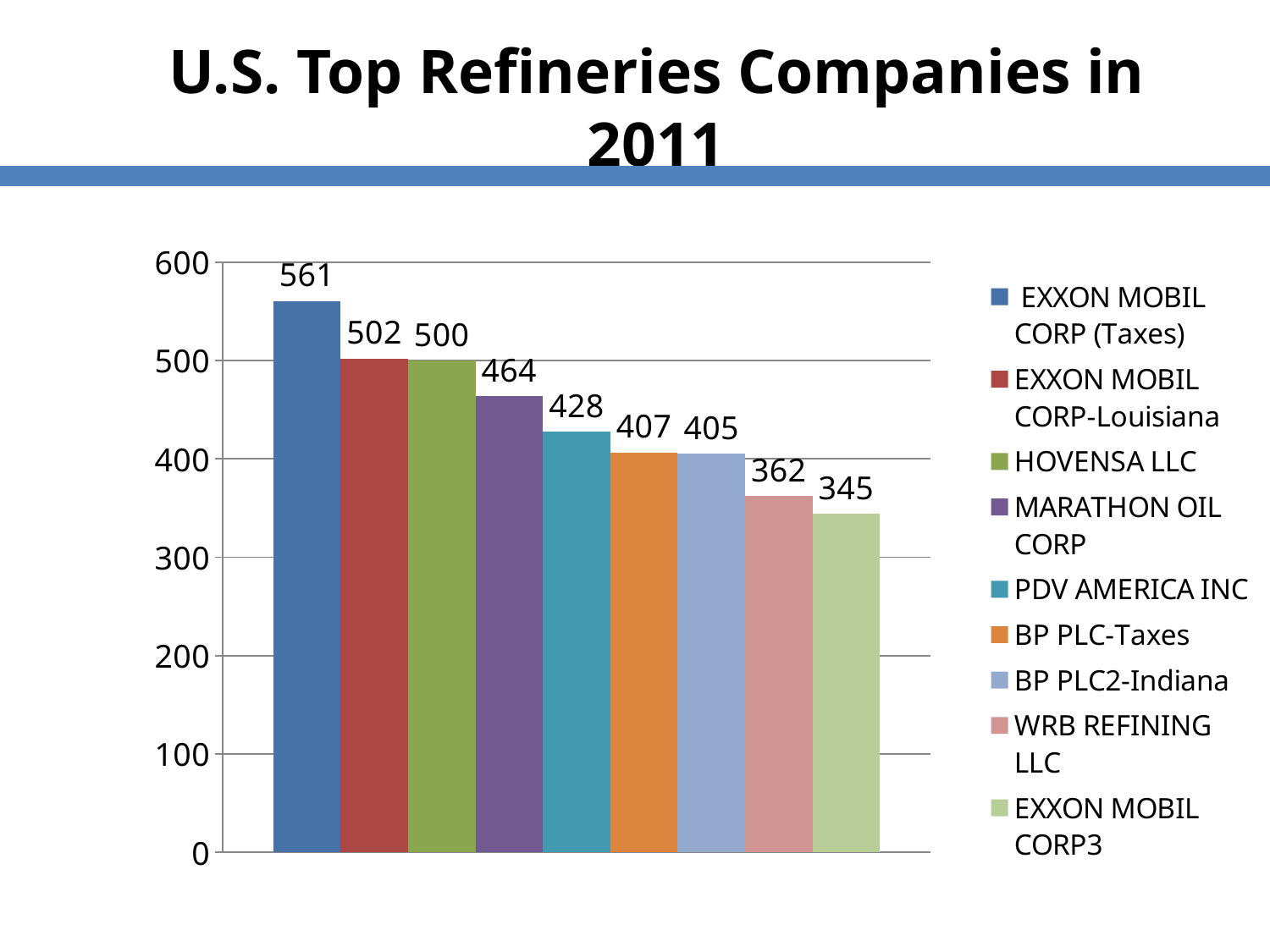
What is the difference between the values for EXXON MOBIL CORP (Taxes) and EXXON MOBIL CORP3? 216 What is the value for WRB REFINING LLC? 362 What is the value for EXXON MOBIL CORP (Taxes)? 561 What is the value for HOVENSA LLC? 500 What is the difference between the values for MARATHON OIL CORP and PDV AMERICA INC? 36 How many companies are shown in the chart? 9 What is the value for PDV AMERICA INC? 428 What kind of chart is shown on the slide? Bar chart Which company has the highest value? EXXON MOBIL CORP (Taxes) Which company has the lowest value? EXXON MOBIL CORP3 Do the values rise or fall from left to right across the bars? Fall Which is larger, the value for EXXON MOBIL CORP-Louisiana or the value for MARATHON OIL CORP? EXXON MOBIL CORP-Louisiana